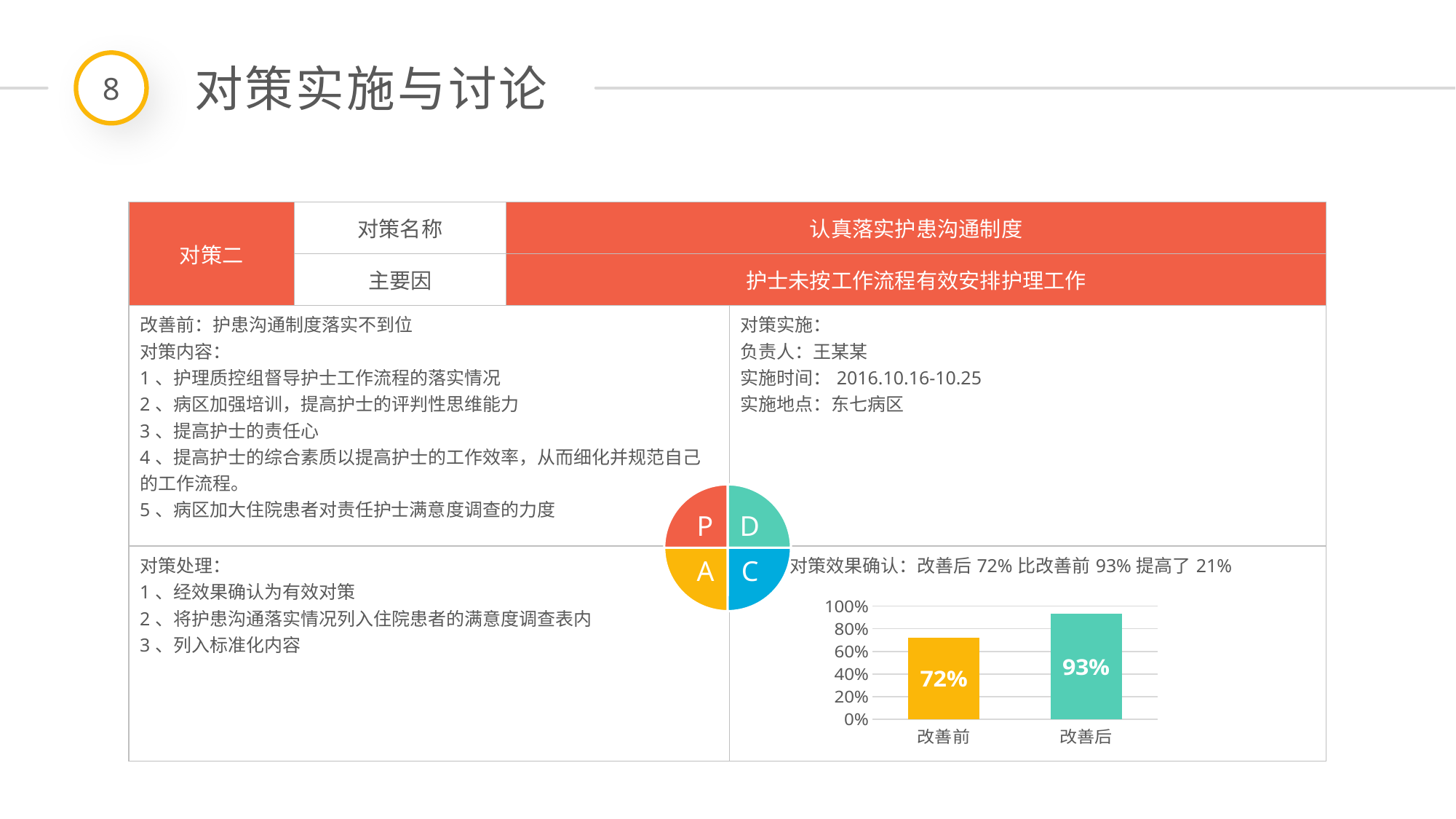
What kind of chart is shown on the slide? a pie chart (the PDCA wheel) and a bar chart How many categories are shown in the bar chart? 2 Which category has the lowest value in the bar chart? 改善前 Which is larger in the bar chart, 改善前 or 改善后? 改善后 What is the value for 改善前 in the bar chart? 72% What is the value for 改善后 in the bar chart? 93% Is the value for 改善前 greater or less than 80%? less Is the value for 改善后 greater or less than 80%? greater Do the values rise or fall from 改善前 to 改善后 in the bar chart? rise What is the maximum value shown on the y axis of the bar chart? 100% Which category has the highest value in the bar chart? 改善后 What is the difference between the values for 改善后 and 改善前 in the bar chart? 21%